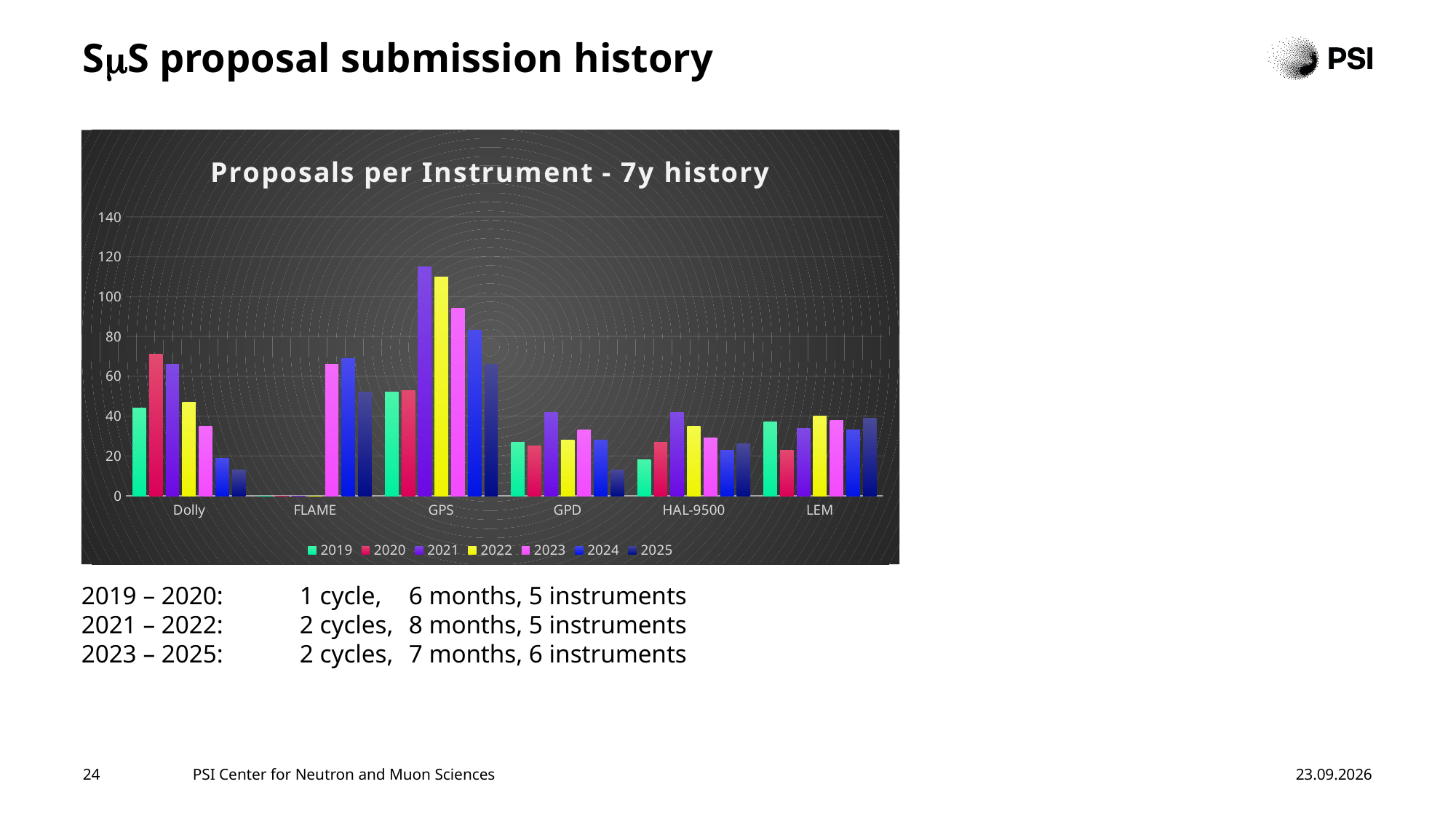
Is the value for GPS in 2021 greater or less than 100? greater Is the value for FLAME in 2024 greater or less than 60? greater Which year has the highest bar for HAL-9500? 2021 How many instruments are shown on the x axis? 6 Is the value for GPD in 2025 greater or less than 20? less What is the title of the chart? Proposals per Instrument - 7y history Which instrument has the highest bar for 2021? GPS How many series does the legend list? 7 What kind of chart is shown on the slide? bar chart For Dolly, do the values rise or fall from 2020 to 2025? fall For Dolly, which is larger: the 2020 value or the 2025 value? 2020